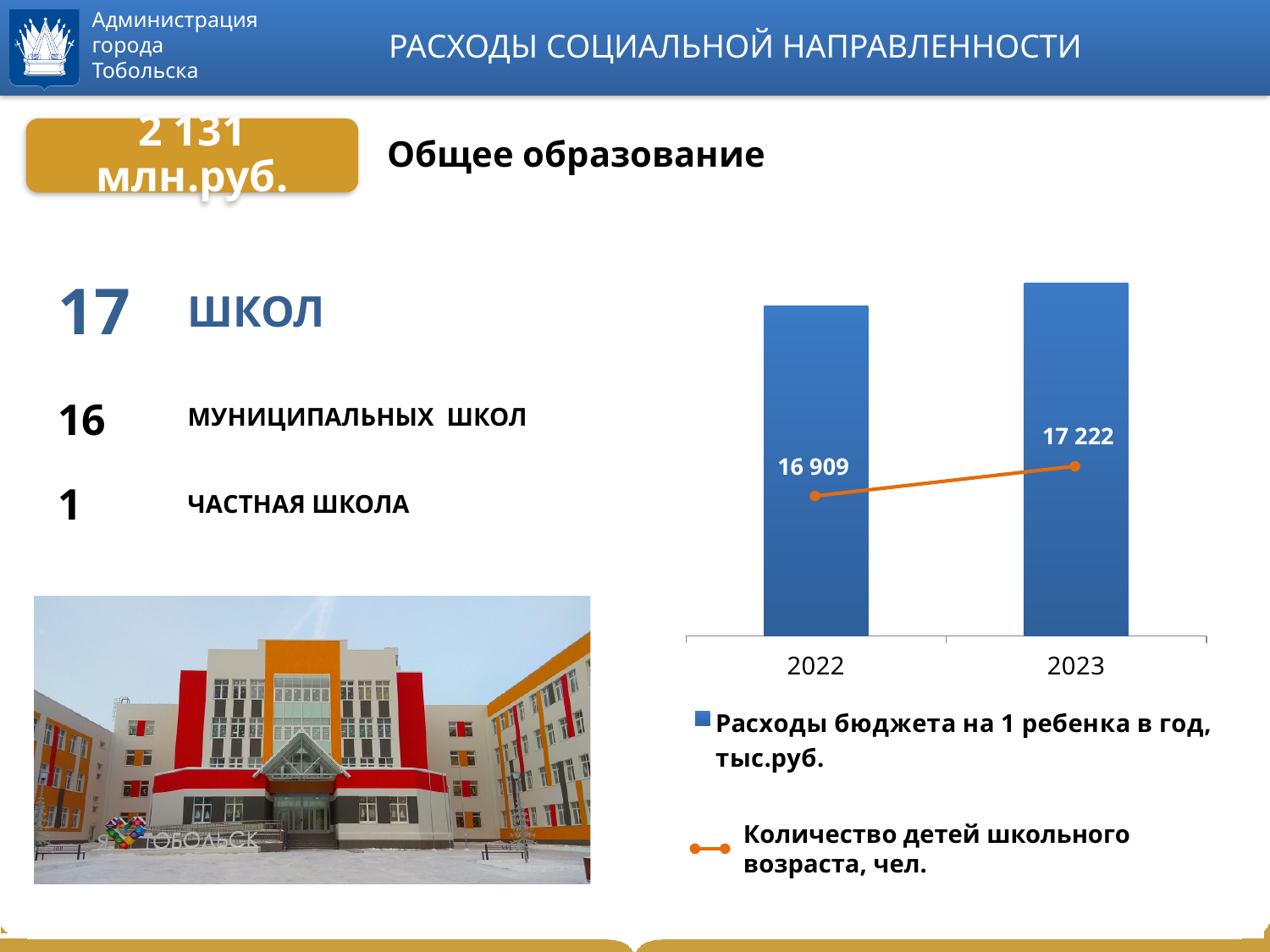
Which series in the legend is represented by the blue bars? Расходы бюджета на 1 ребенка в год, тыс.руб. What colour is the line showing the number of school-age children? orange What is the number of school-age children (Количество детей школьного возраста, чел.) shown for 2022? 16 909 What is the number of school-age children (Количество детей школьного возраста, чел.) shown for 2023? 17 222 By how much did the number of school-age children increase from 2022 to 2023? 313 Does the budget expenditure per child (the bars) rise or fall from 2022 to 2023? rises Which year has the taller bar for budget expenditure per child, 2022 or 2023? 2023 How many years are shown on the x axis of the chart? 2 Does the number of school-age children rise or fall from 2022 to 2023? rises What kind of chart is used to show the budget expenditure per child series? bar chart How many series does the chart legend list? 2 Which year has the larger number of school-age children, 2022 or 2023? 2023